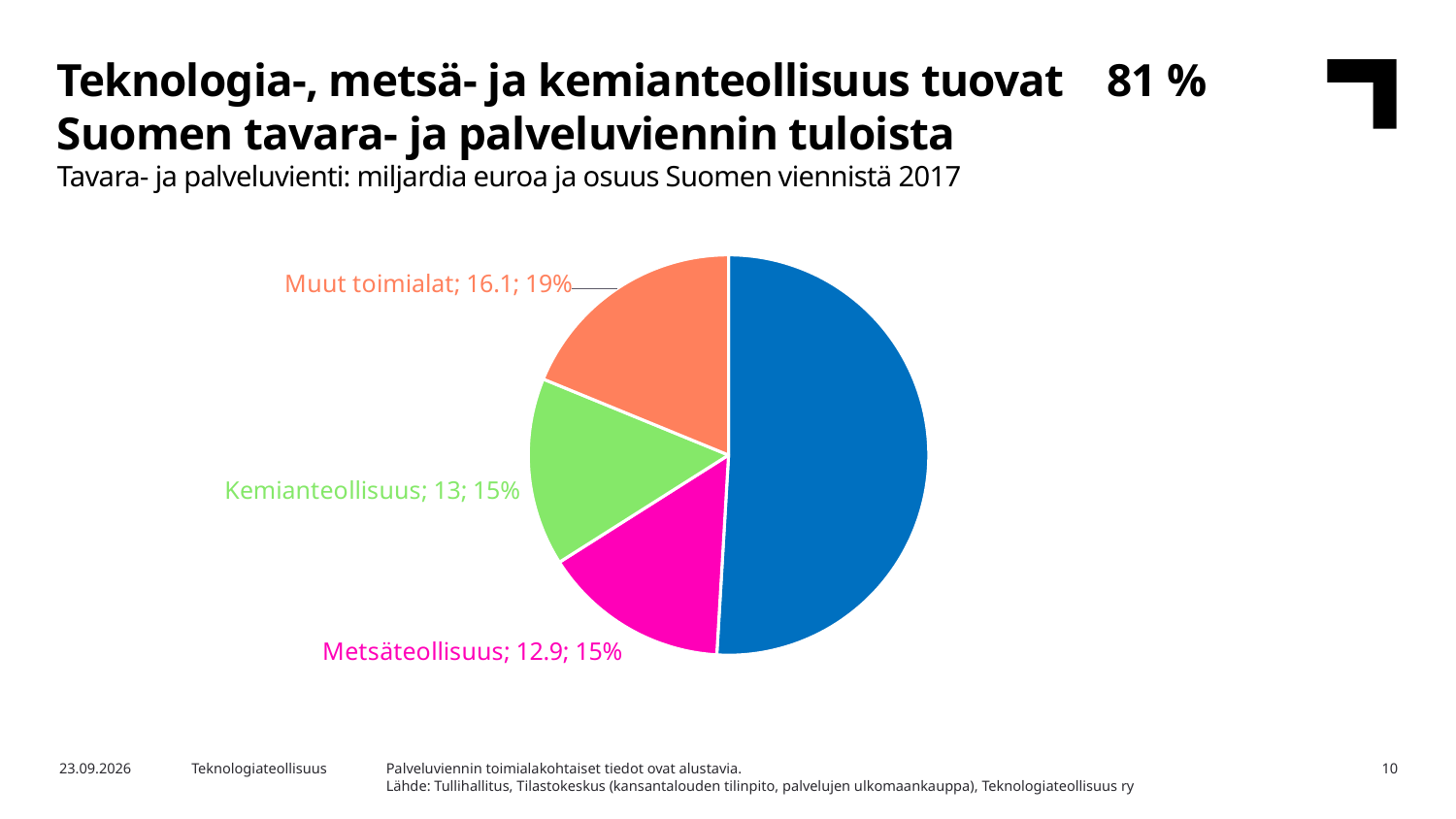
How many slices does the pie chart have? 4 What is the value in billions of euros for Kemianteollisuus? 13 What share of Finland's exports does Metsäteollisuus account for? 15% Of the labeled slices, which has the largest value? Muut toimialat What kind of chart is shown on the slide? pie chart What share of Finland's exports does Muut toimialat account for? 19% What share of Finland's exports does Kemianteollisuus account for? 15% What is the value in billions of euros for Metsäteollisuus? 12.9 Which has the larger value, Muut toimialat or Kemianteollisuus? Muut toimialat What is the difference in billions of euros between Muut toimialat and Metsäteollisuus? 3.2 What colour is the Metsäteollisuus slice? magenta (pink) What is the value in billions of euros for Muut toimialat? 16.1